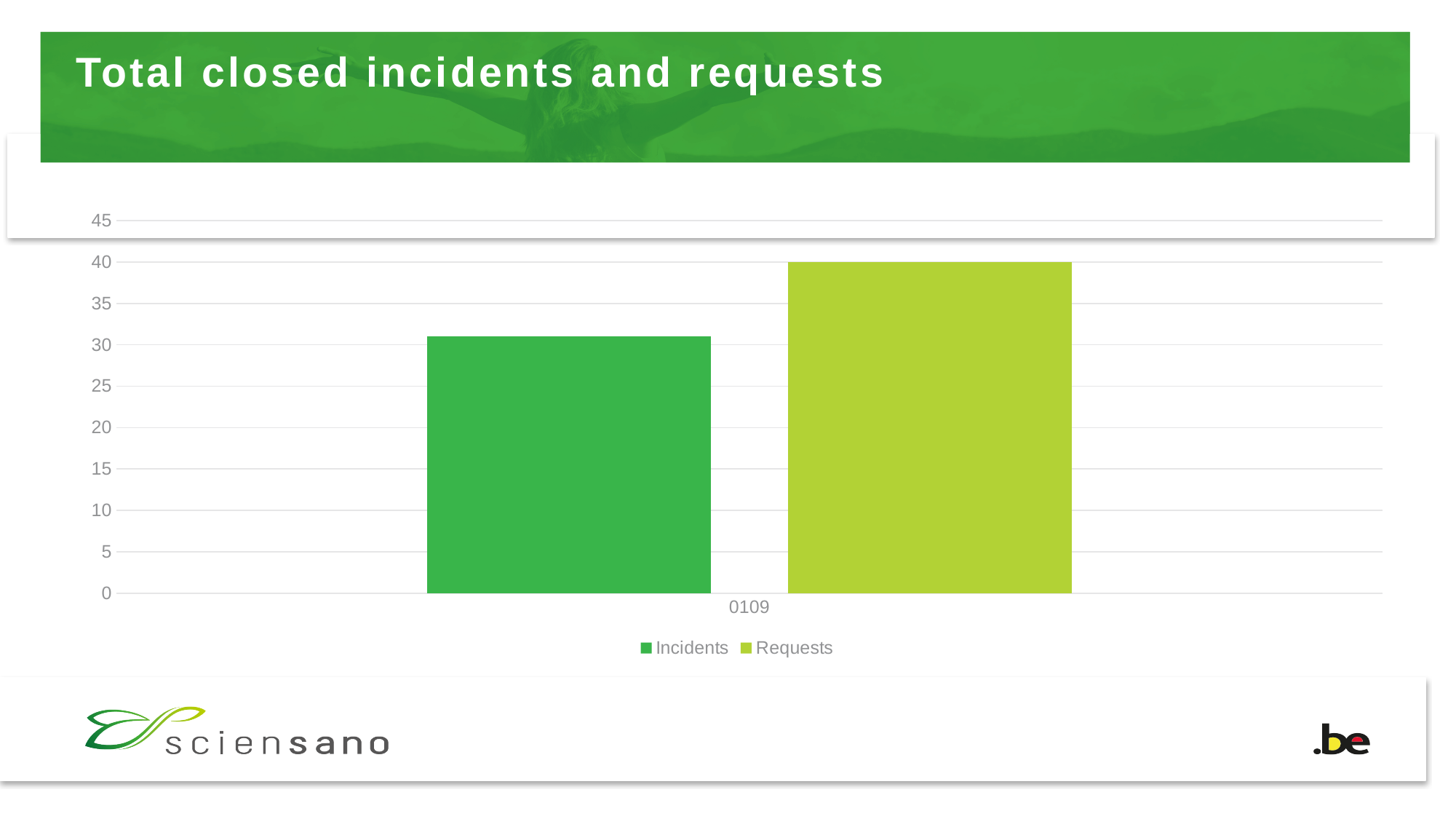
Which series are listed in the legend? Incidents, Requests What is the title of the chart? Total closed incidents and requests What kind of chart is shown on the slide? bar chart How many series does the legend list? 2 Which series has the higher value for 0109, Incidents or Requests? Requests Which series has the lowest bar? Incidents Is the value for Incidents greater or less than 35? less What is the value for Requests in category 0109? 40 Is the value for Requests greater or less than 35? greater How many categories are shown on the x axis? 1 Which series has the highest bar? Requests